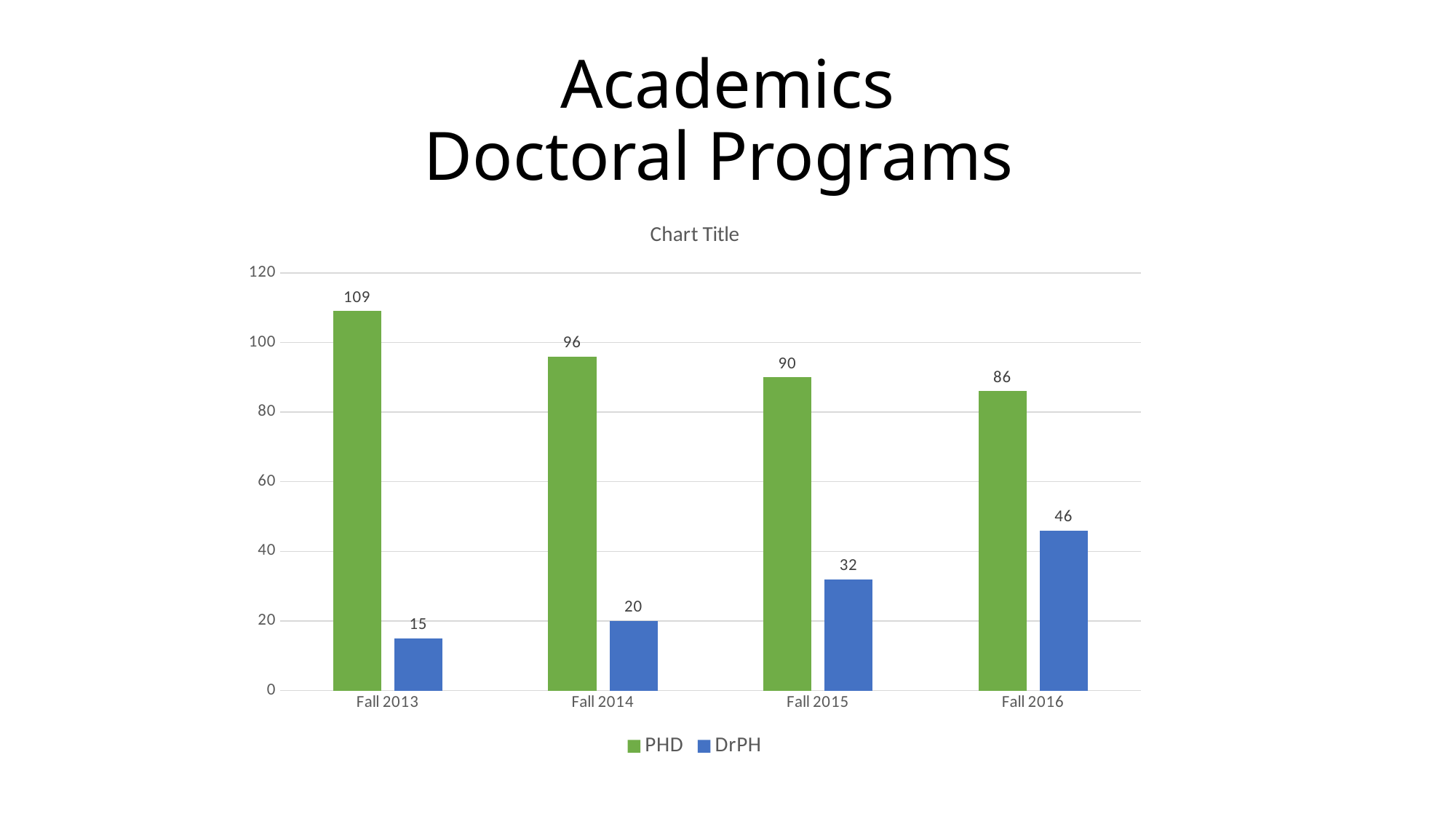
What is the difference between the PHD values for Fall 2013 and Fall 2016? 23 Which period has the highest PHD value? Fall 2013 What is the DrPH value for Fall 2016? 46 What is the difference between the PHD and DrPH values for Fall 2015? 58 How many periods are shown on the x axis? 4 Which period has the lowest DrPH value? Fall 2013 What is the PHD value for Fall 2013? 109 How many series does the legend list? 2 Do the PHD values rise or fall from Fall 2013 to Fall 2016? Fall What kind of chart is shown on the slide? Bar chart Which is larger, the DrPH value for Fall 2015 or the DrPH value for Fall 2014? Fall 2015 What is the DrPH value for Fall 2014? 20